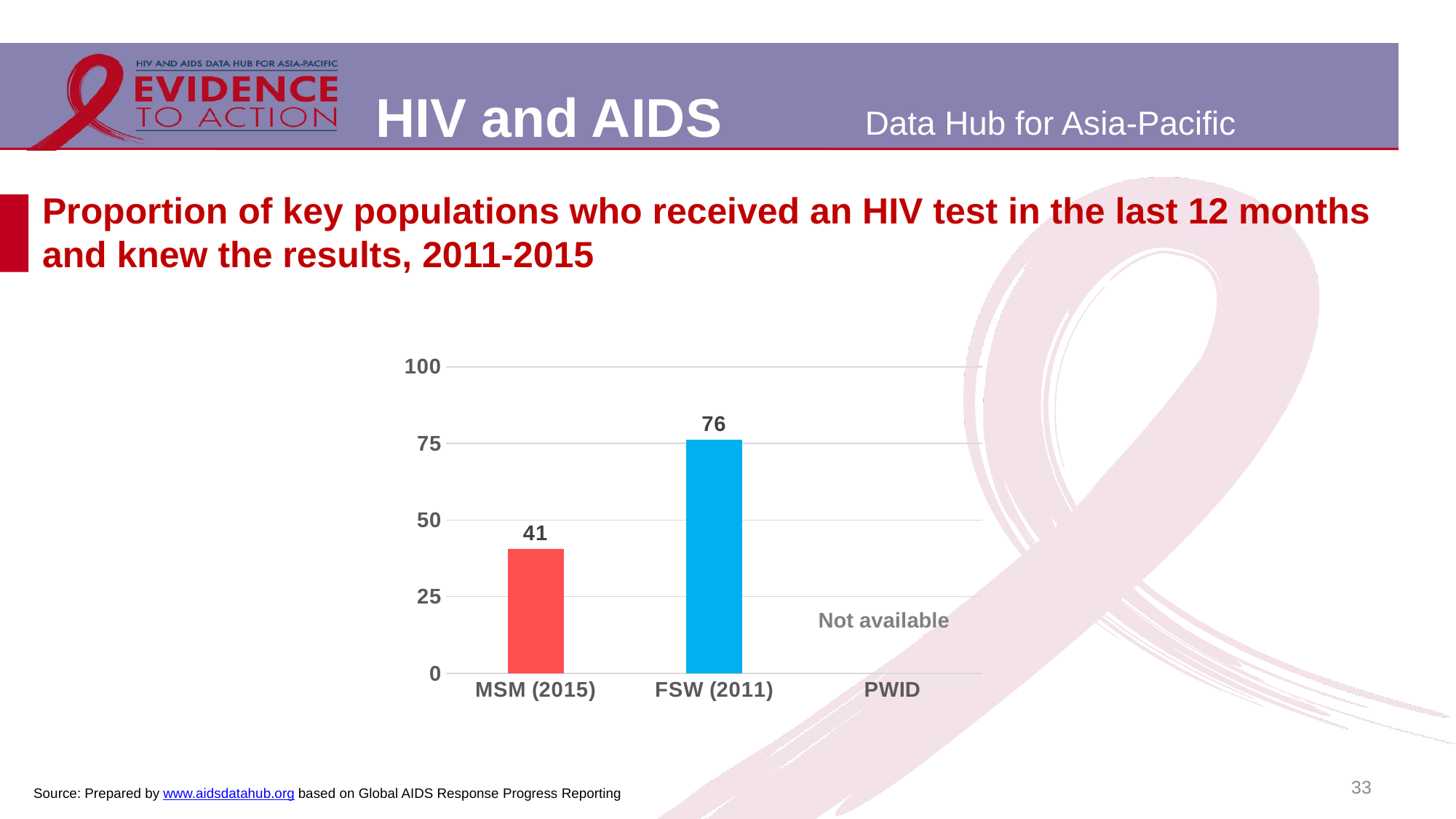
Which category has the highest plotted value? FSW (2011) What is the difference between the values for FSW (2011) and MSM (2015)? 35 What is the value for FSW (2011)? 76 Which category has the lowest plotted value among those with data? MSM (2015) What is shown for PWID on the chart? Not available Is the value for MSM (2015) greater or less than 50? less How many categories are shown on the x axis? 3 Which is larger, the value for MSM (2015) or FSW (2011)? FSW (2011) Is the value for FSW (2011) greater or less than 75? greater What is the maximum value shown on the y axis? 100 What kind of chart is shown on the slide? bar chart What is the value for MSM (2015)? 41